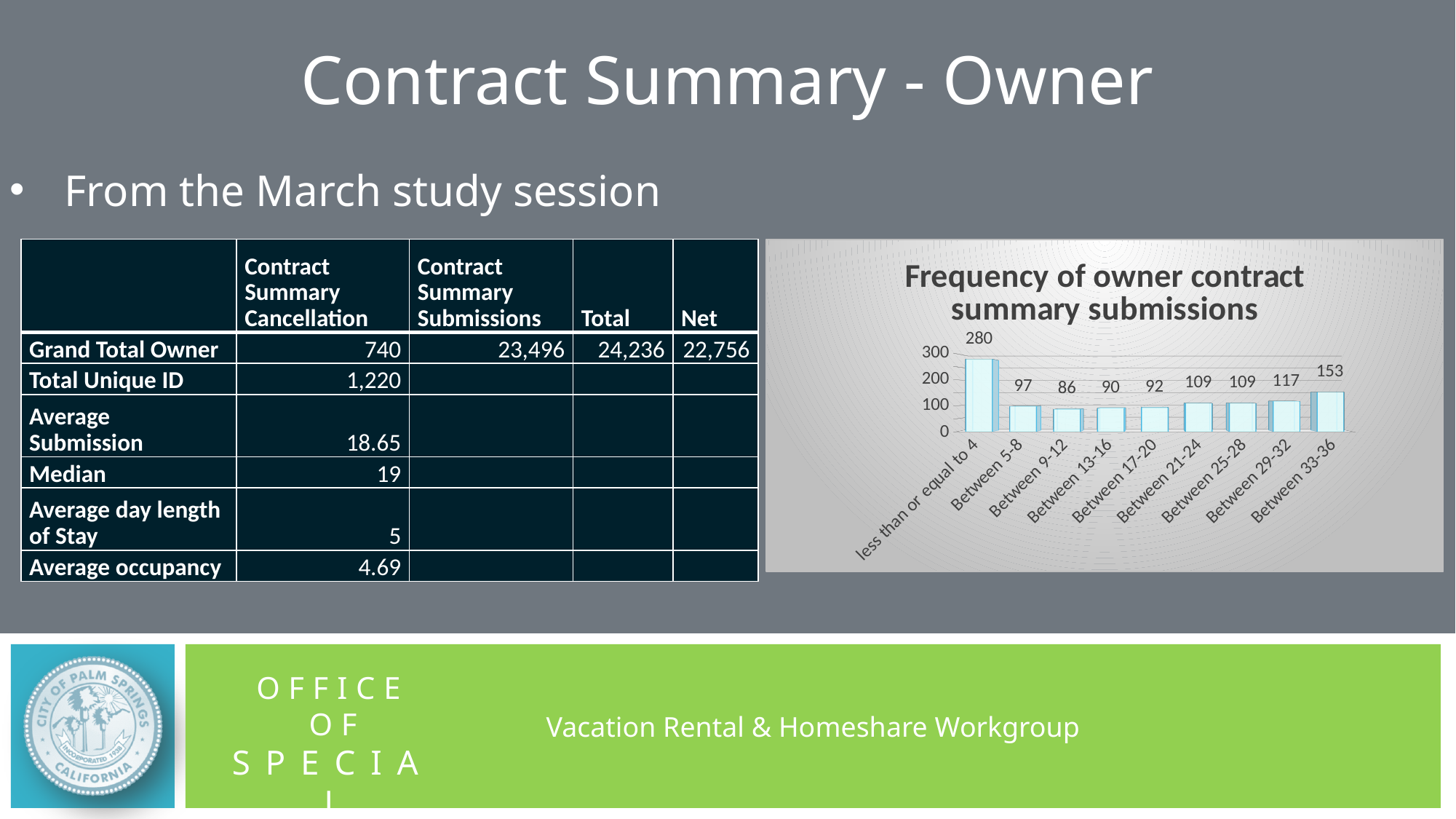
Is the value for 'Between 33-36' greater or less than 100? greater Which category has the highest value in the chart? less than or equal to 4 What is the value for 'Between 9-12' in the chart? 86 What is the value for 'Between 29-32' in the chart? 117 What is the title of the chart? Frequency of owner contract summary submissions What is the value for 'less than or equal to 4' in the Frequency of owner contract summary submissions chart? 280 What is the value for 'Between 33-36' in the chart? 153 Which is larger, the value for 'Between 5-8' or the value for 'Between 17-20'? Between 5-8 Which category has the lowest value in the chart? Between 9-12 What kind of chart is shown on the slide? bar chart How many categories are shown in the chart? 9 What is the difference between the values for 'less than or equal to 4' and 'Between 33-36'? 127